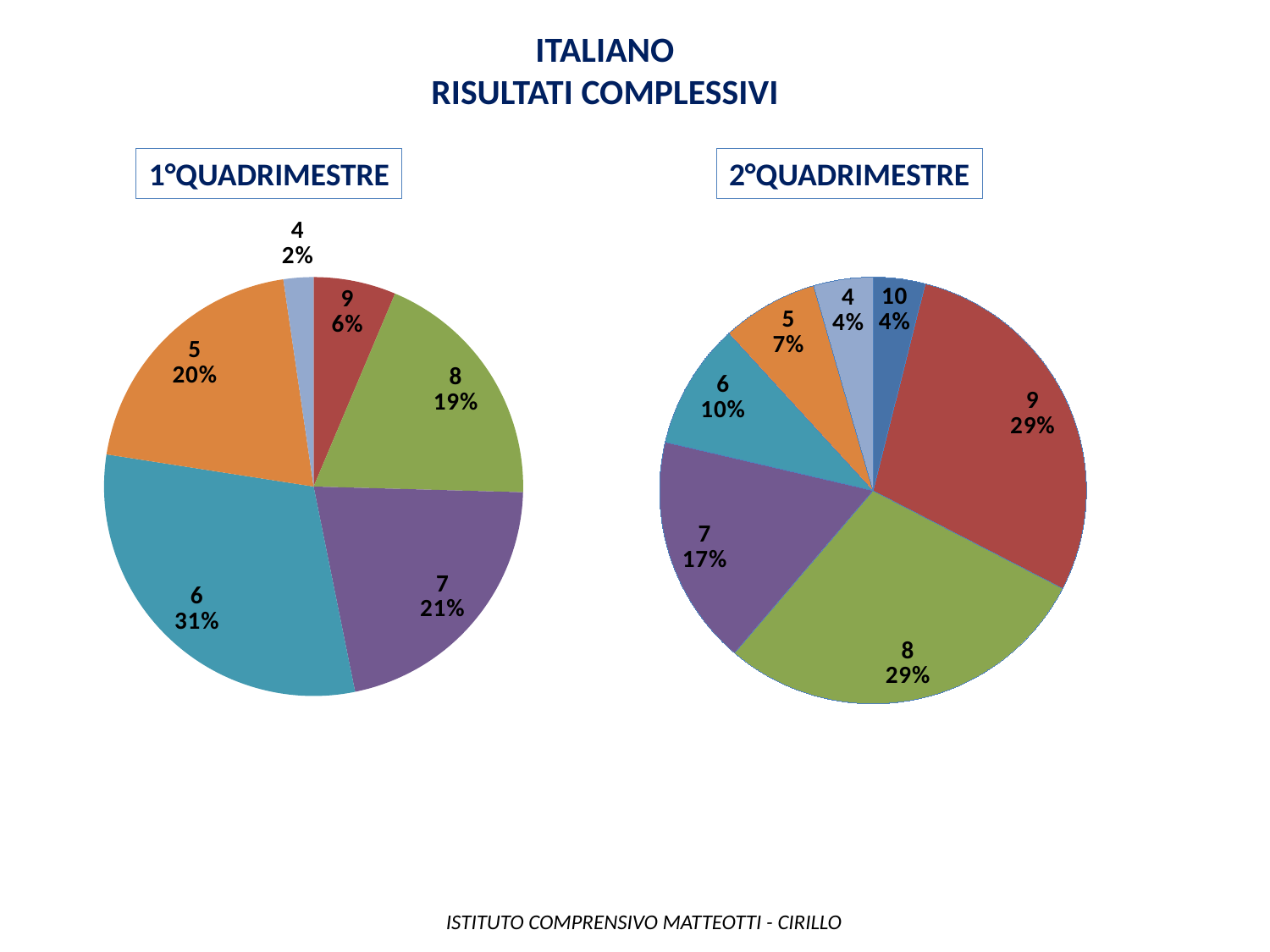
In the 2°QUADRIMESTRE pie chart, what share does grade 7 have? 17% In the 1°QUADRIMESTRE pie chart, how many slices are there? 6 In the 2°QUADRIMESTRE pie chart, what is the difference in percentage points between grade 9 and grade 7? 12 In the 2°QUADRIMESTRE pie chart, what share does grade 6 have? 10% In the 1°QUADRIMESTRE pie chart, which grade has the largest slice? 6 In the 1°QUADRIMESTRE pie chart, which grade has the smallest slice? 4 What type of chart is used on this slide? Pie chart In the 2°QUADRIMESTRE pie chart, how many slices are there? 7 In the 1°QUADRIMESTRE pie chart, what share does grade 6 have? 31% In the 2°QUADRIMESTRE pie chart, which is larger, the slice for grade 5 or the slice for grade 6? 6 In the 1°QUADRIMESTRE pie chart, what is the difference in percentage points between grade 7 and grade 5? 1